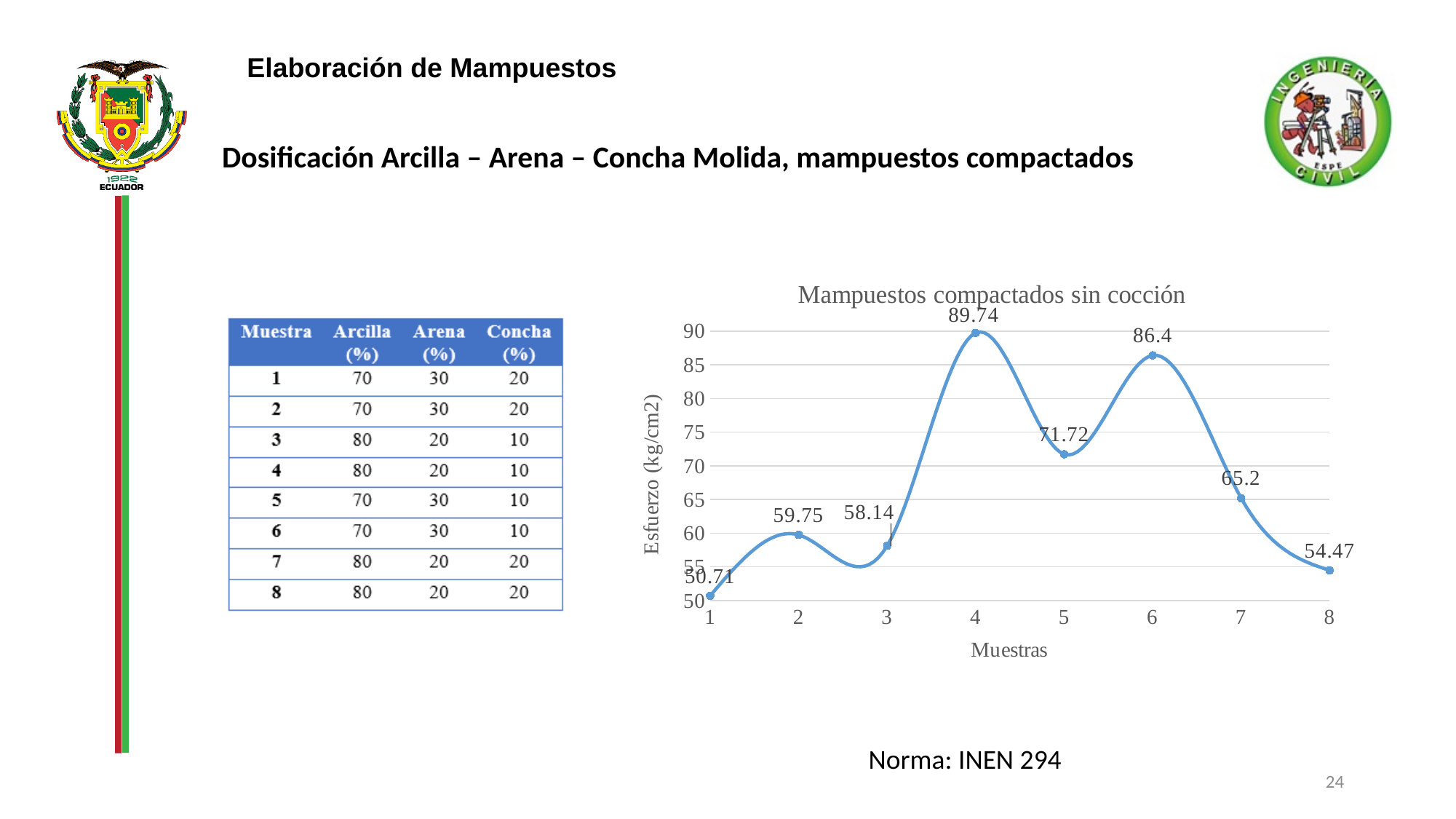
Which Muestra has the highest Esfuerzo value? 4 Which has a larger Esfuerzo value, Muestra 5 or Muestra 7? Muestra 5 Does the Esfuerzo value rise or fall from Muestra 6 to Muestra 8? fall What is the label of the y axis of the chart? Esfuerzo (kg/cm2) What type of chart is shown on the slide? line chart What is the title of the chart? Mampuestos compactados sin cocción Which Muestra has the lowest Esfuerzo value? 1 What is the difference between the Esfuerzo values for Muestra 4 and Muestra 6? 3.34 What is the Esfuerzo value for Muestra 4? 89.74 What is the Esfuerzo value for Muestra 1? 50.71 How many Muestras (data points) are plotted on the chart? 8 What is the Esfuerzo value for Muestra 8? 54.47